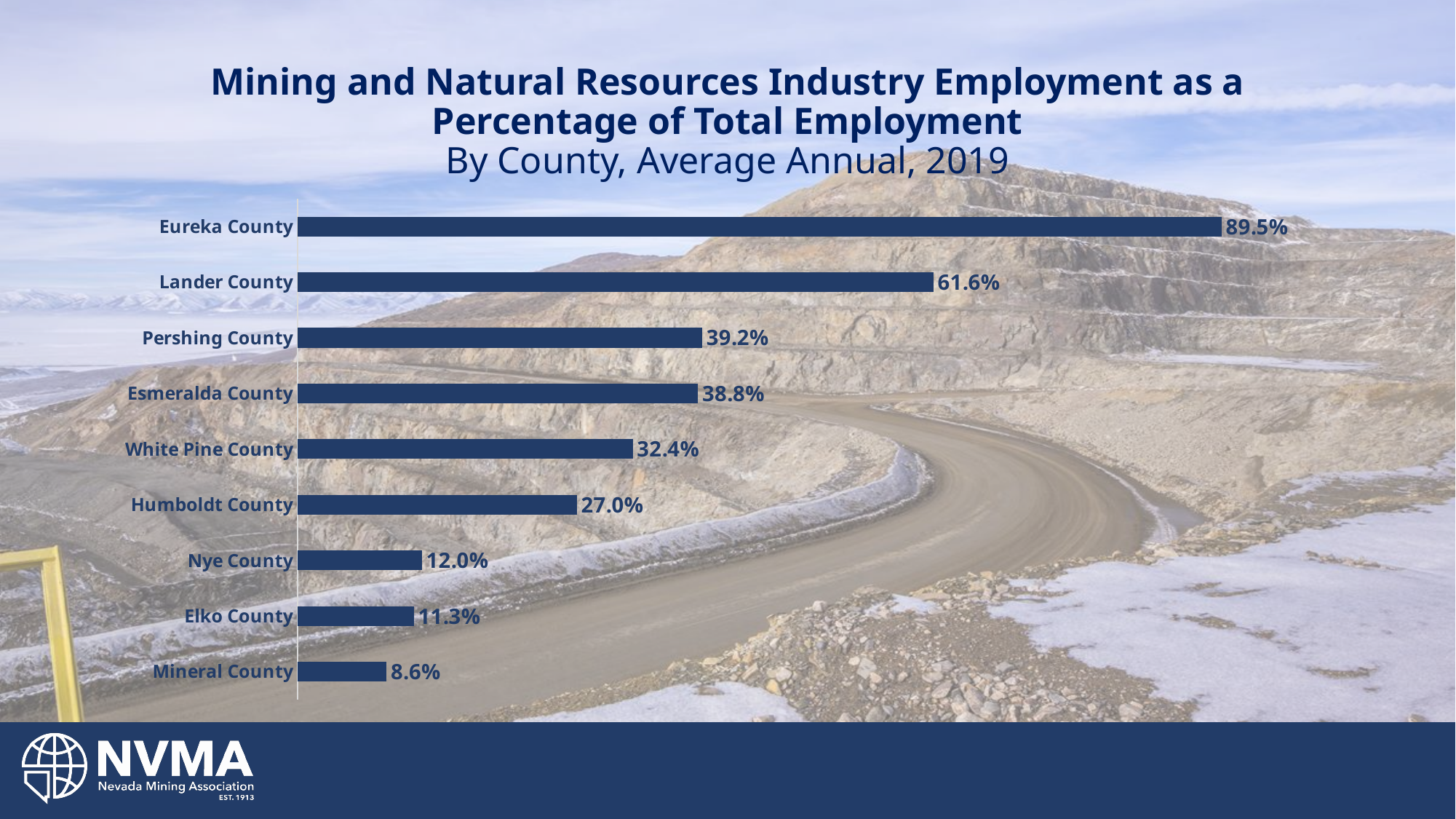
What is the value for Humboldt County? 27.0% How many counties are shown in the chart? 9 Which county has the highest value? Eureka County What is the difference between the values for Eureka County and Lander County? 27.9% Which is larger, the value for White Pine County or the value for Humboldt County? White Pine County What is the difference between the values for Nye County and Mineral County? 3.4% What kind of chart is shown on the slide? Bar chart What year does the chart's data cover? 2019 What is the value for Pershing County? 39.2% Which county has the lowest value? Mineral County What is the value for Elko County? 11.3% What is the value for Eureka County? 89.5%